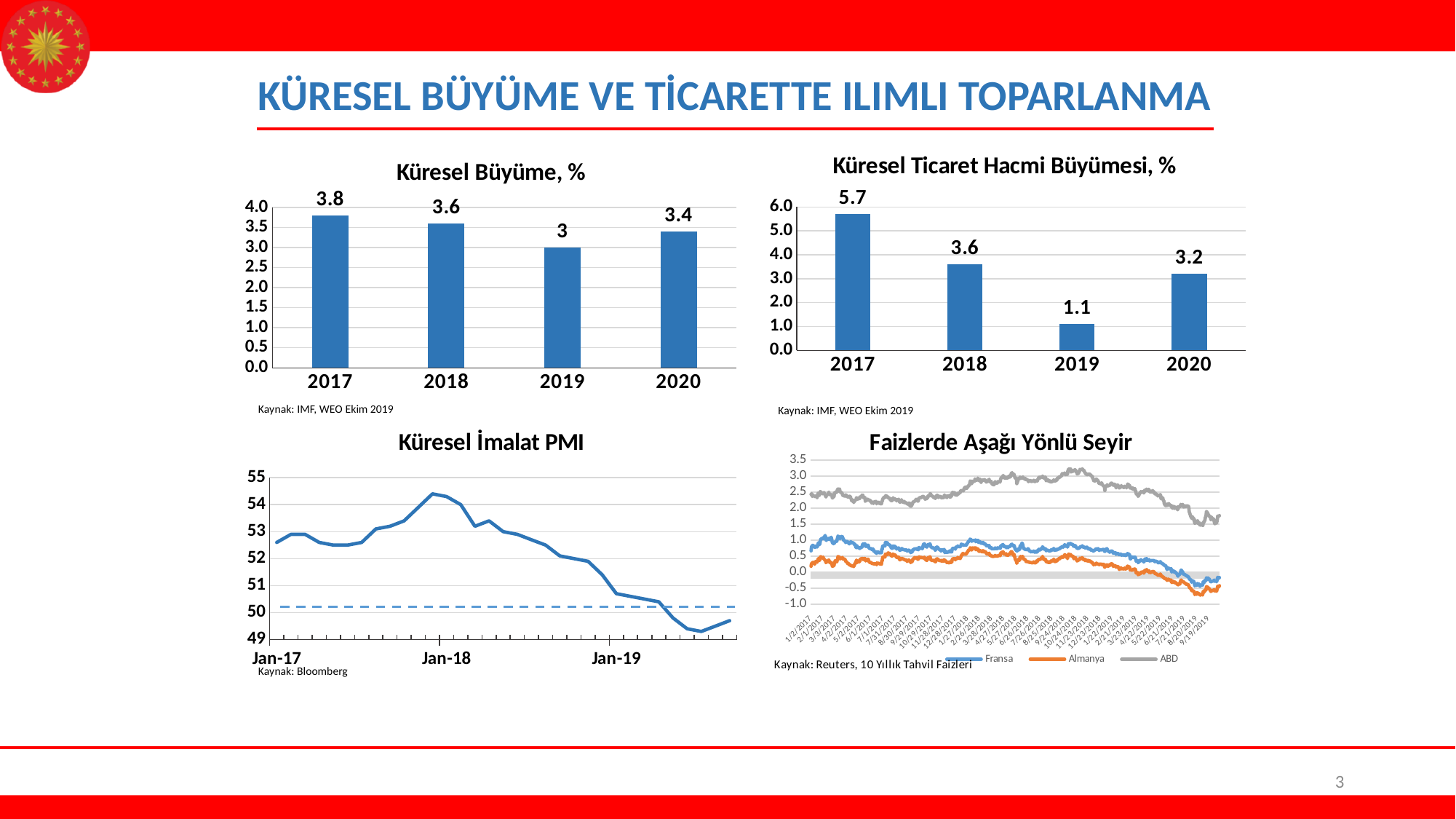
In the 'Küresel Büyüme, %' chart, what is the difference between the 2017 and 2019 values? 0.8 How many series does the legend of the 'Faizlerde Aşağı Yönlü Seyir' chart list? 3 In the 'Küresel Büyüme, %' chart, which year has the lowest value? 2019 In the 'Küresel Ticaret Hacmi Büyümesi, %' chart, what is the value for 2019? 1.1 How many years are shown in the 'Küresel Büyüme, %' chart? 4 In the 'Küresel Büyüme, %' chart, what is the value for 2017? 3.8 In the 'Küresel Ticaret Hacmi Büyümesi, %' chart, which year has the highest value? 2017 In the 'Küresel Ticaret Hacmi Büyümesi, %' chart, what is the difference between the 2017 and 2018 values? 2.1 In the 'Küresel İmalat PMI' chart, do values rise or fall from Jan-18 to the end of the series? fall In the 'Küresel Ticaret Hacmi Büyümesi, %' chart, is the value for 2018 or 2020 larger? 2018 In the 'Küresel İmalat PMI' chart, is the value at Jan-18 greater or less than 54? greater What kind of chart is 'Küresel İmalat PMI'? line chart